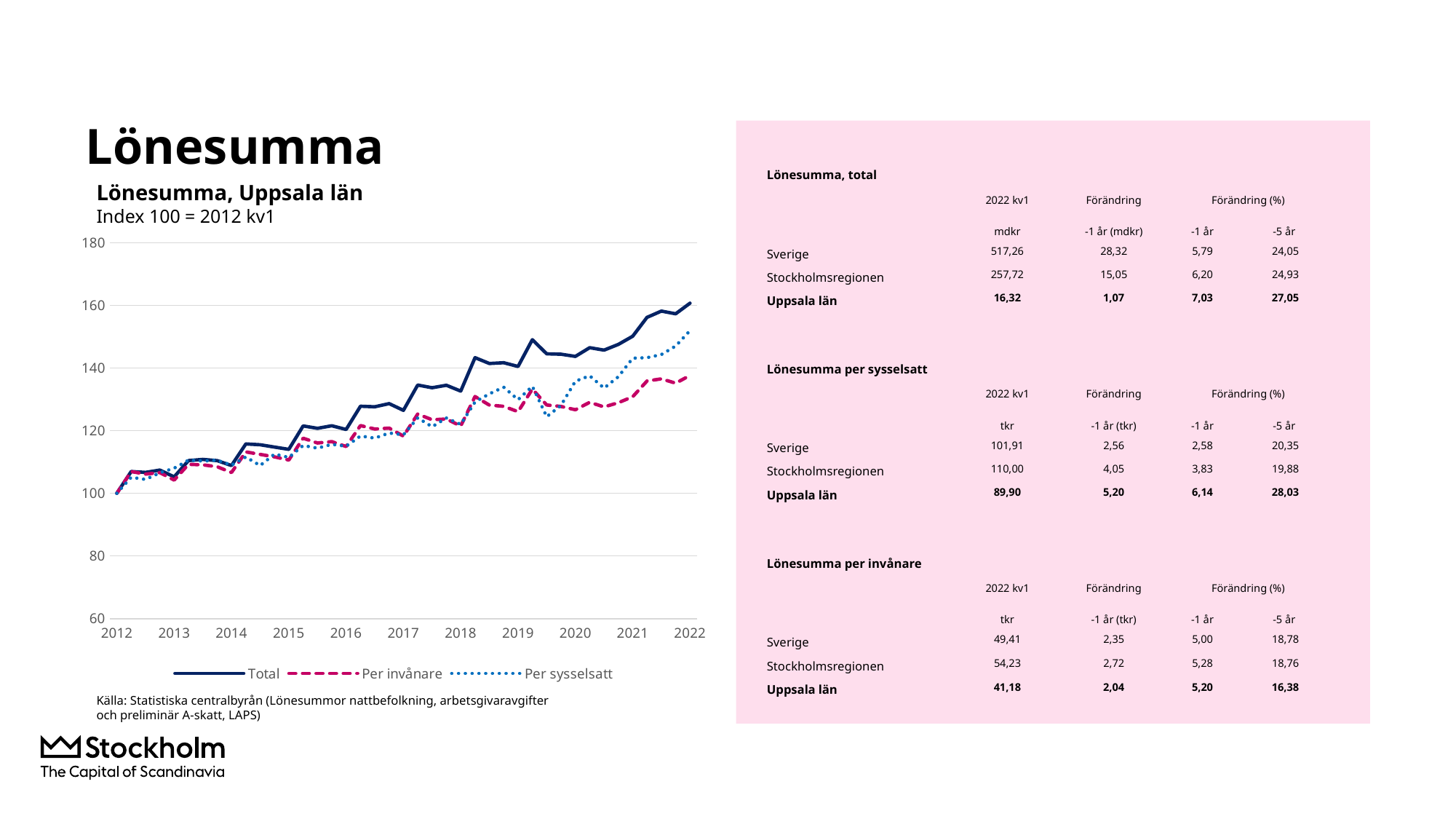
Does the Total series rise or fall from 2012 to 2022? Rise What is the title of the chart? Lönesumma, Uppsala län Is the value of the Total series at 2022 greater or less than 140? greater What kind of chart is shown on the slide? Line chart How many year labels are shown on the x axis of the chart? 11 What is the index value of the series at 2012 kv1, the base period? 100 Is the value of the Per sysselsatt series at 2022 greater or less than 140? greater How many series does the legend of the chart list? 3 Which series has the highest value at the end of the chart in 2022? Total Which series are listed in the chart legend? Total, Per invånare, Per sysselsatt Which series has the lowest value at the end of the chart in 2022? Per invånare At 2022, which is larger: the Per sysselsatt series or the Per invånare series? Per sysselsatt